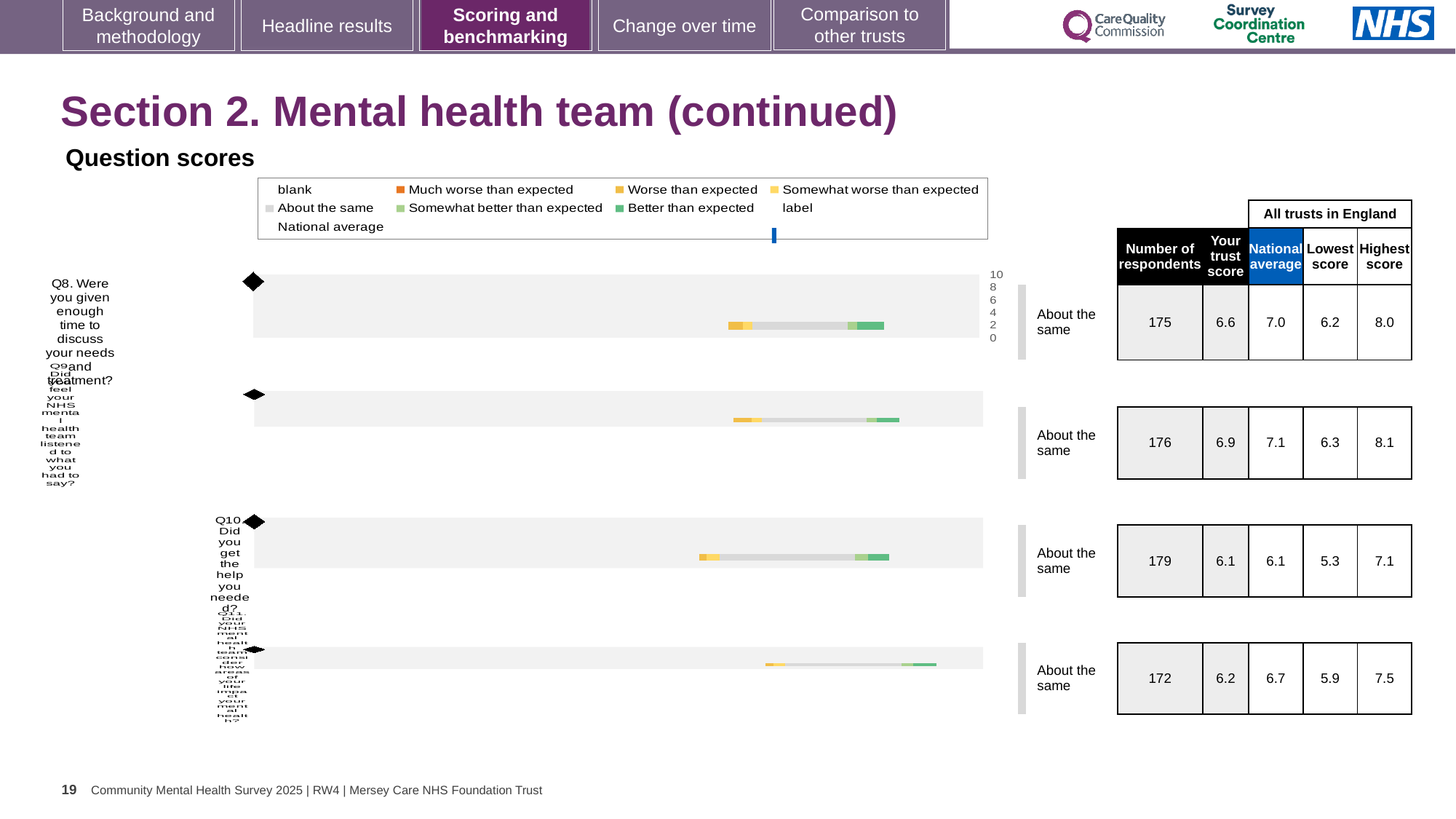
For the Q8 chart, which is larger in the table: the trust score or the national average? National average How many question charts are shown on the slide? 4 What is the maximum value shown on the score axis of the charts? 10 What benchmark label is shown beside the Q8 chart? About the same In the table next to the Q8 chart, what is the national average? 7.0 In the table next to the Q10 chart, what is the lowest score among all trusts in England? 5.3 What kind of chart is used to show the question scores on this slide? bar chart In the table next to the Q8 chart, what is the trust score? 6.6 Which question chart has the highest number of respondents in the table? Q10 In the table next to the Q8 chart, what is the number of respondents? 175 In the table next to the Q10 chart, what is the highest score among all trusts in England? 7.1 For the Q8 chart, what is the difference between the highest score and the lowest score in the table? 1.8